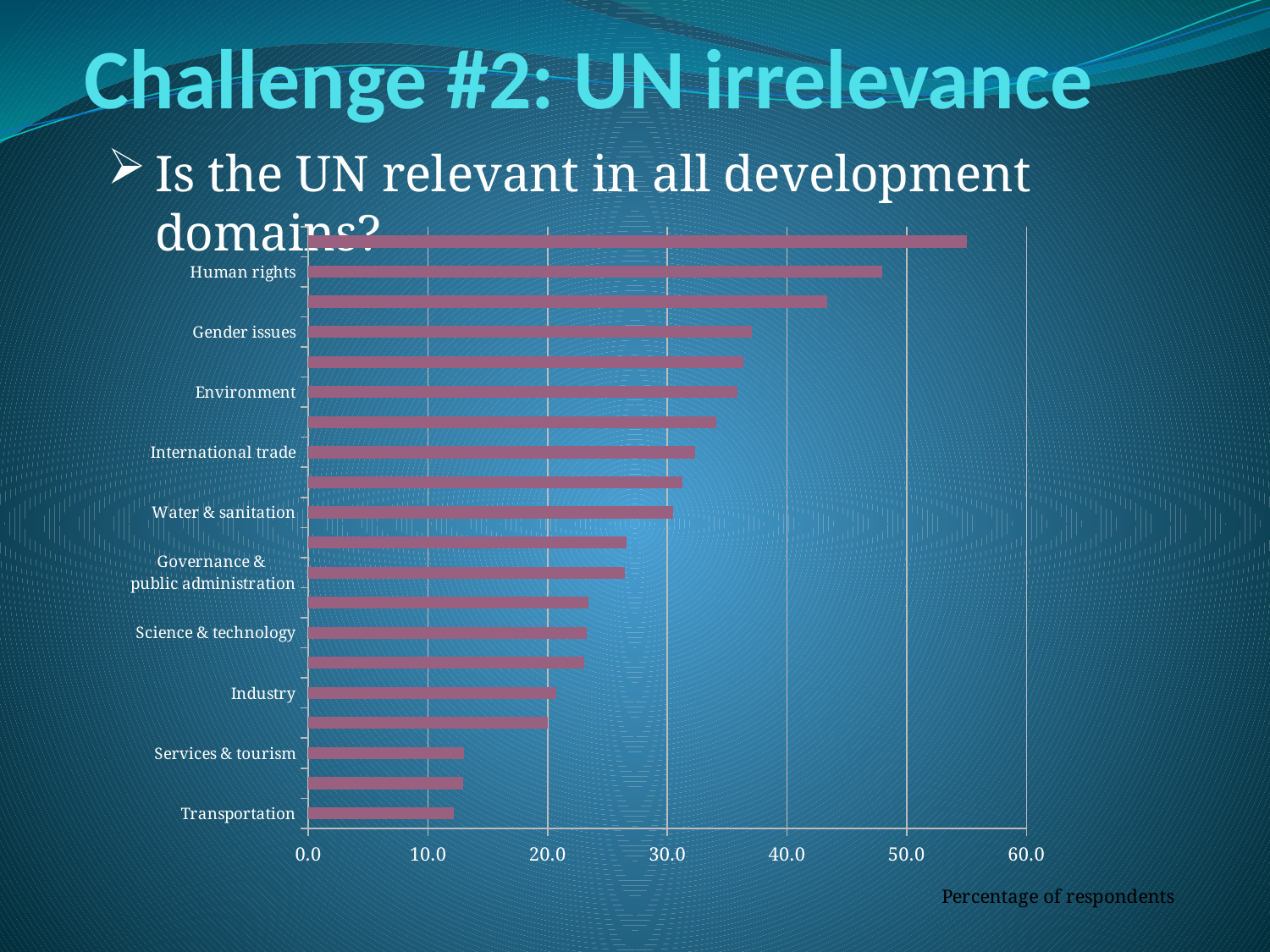
Is the value for Science & technology greater or less than 30.0? less Is the value for Gender issues greater or less than 30.0? greater Which has the larger value, Environment or Industry? Environment What is the title of the horizontal axis of the chart? Percentage of respondents What kind of chart is shown on the slide? bar chart Is the value for Transportation greater or less than 20.0? less Which has the larger value, Human rights or Transportation? Human rights How many bars are plotted in the chart? 20 How many category labels are shown on the vertical axis of the chart? 10